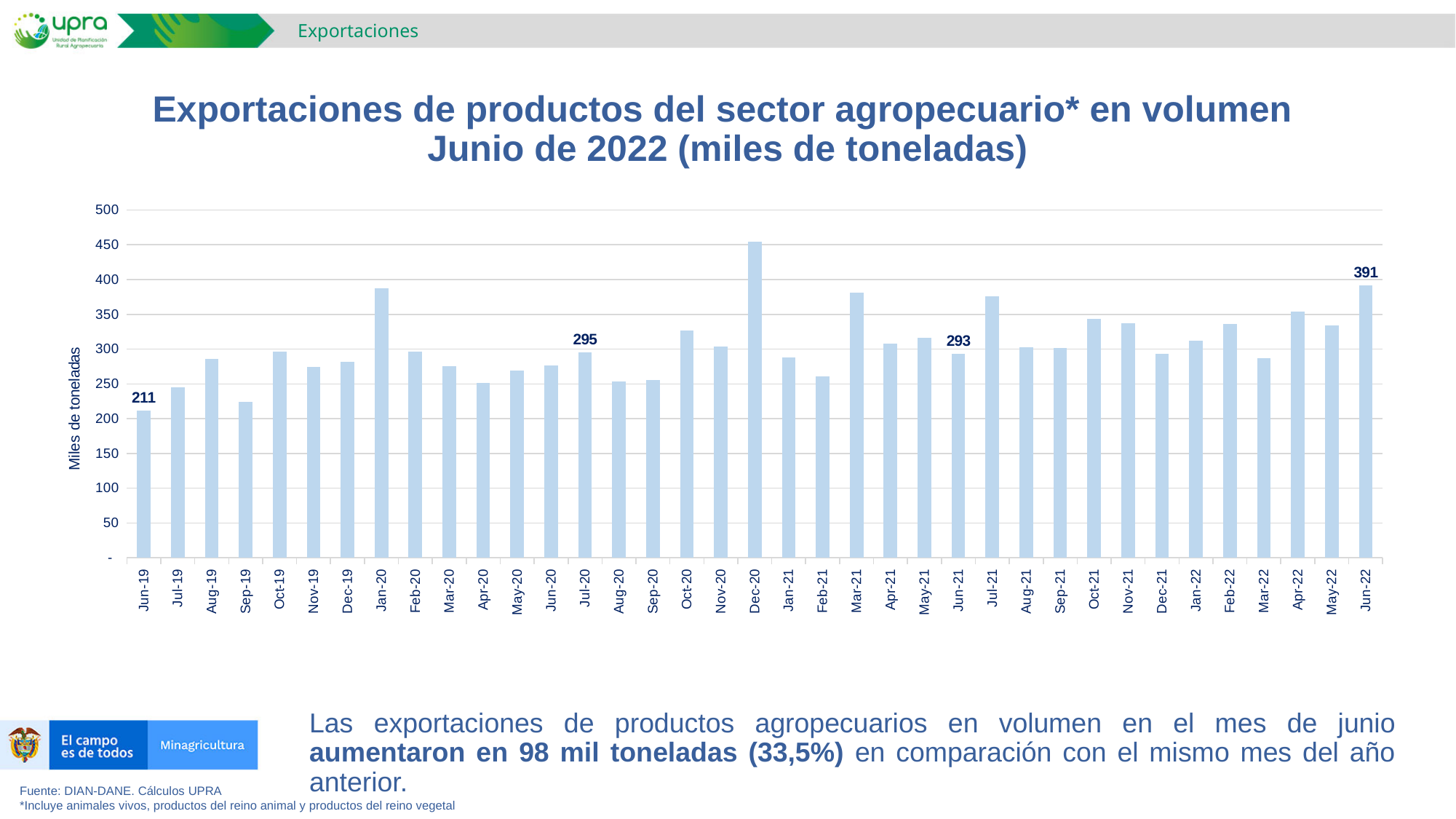
Which is larger, the value for Jul-20 or the value for Jun-21? Jul-20 What is the value for Jun-22? 391 Is the value for Sep-19 greater or less than 250? less Which month has the highest bar? Dec-20 How many months are shown on the x axis? 37 What is the value for Jun-19? 211 Which month has the lowest bar? Jun-19 What is the value for Jul-20? 295 Is the value for Dec-20 greater or less than 400? greater What is the value for Jun-21? 293 What is the difference between the values for Jun-22 and Jun-21? 98 What kind of chart is shown on the slide? bar chart